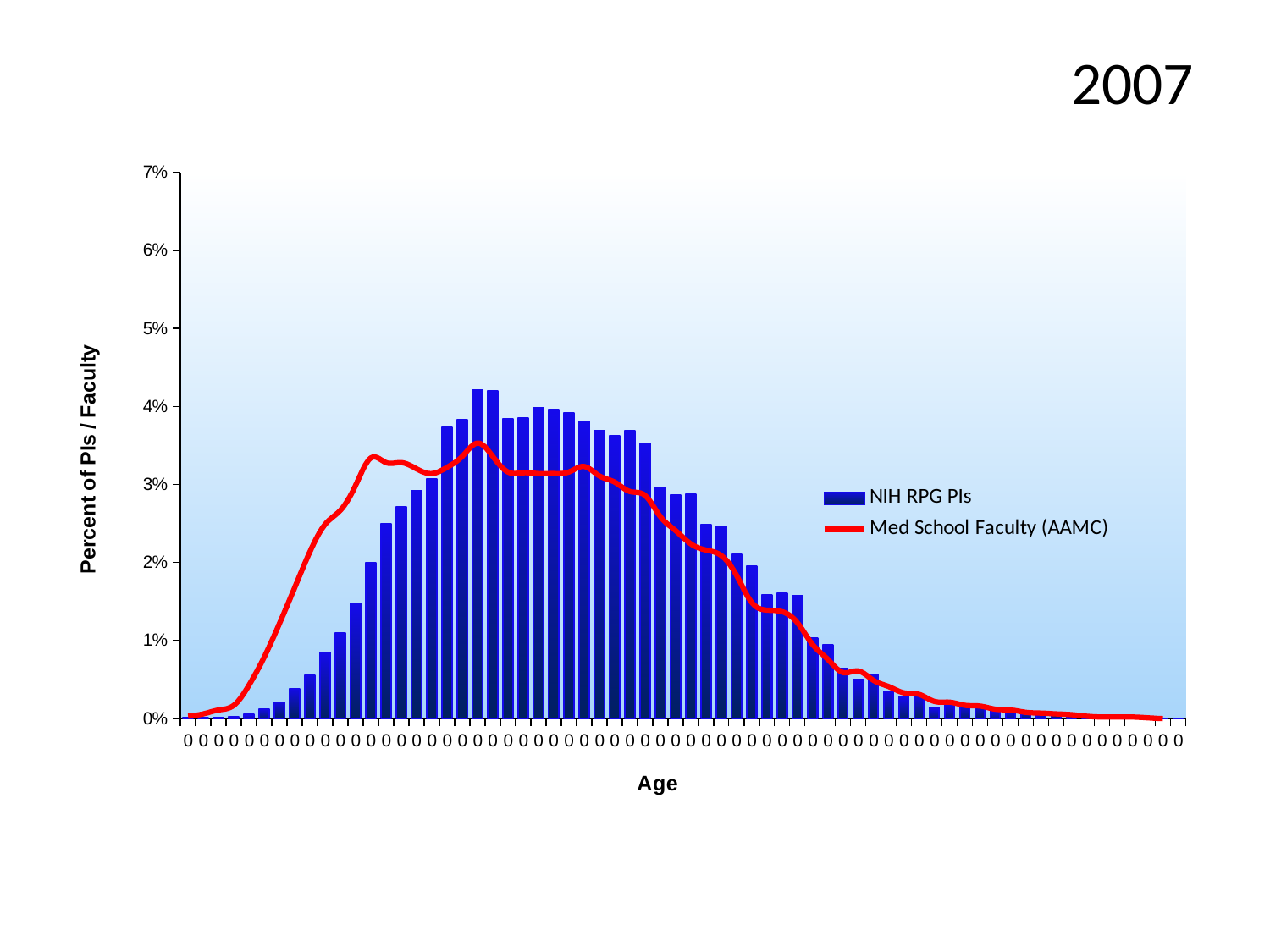
What kind of chart is shown on the slide? bar and line chart How many series does the legend list? 2 Is the highest bar value for NIH RPG PIs greater or less than 5%? less Is the peak value of the Med School Faculty (AAMC) line greater or less than 4%? less Is the highest bar value for NIH RPG PIs greater or less than 4%? greater What year is shown as the title of the slide? 2007 What are the two series named in the legend? NIH RPG PIs and Med School Faculty (AAMC) Toward the right end of the x axis, do the NIH RPG PIs bar values rise or fall? fall At the far left of the x axis, which series has the higher values, NIH RPG PIs or Med School Faculty (AAMC)? Med School Faculty (AAMC) Which series reaches the higher peak value, NIH RPG PIs or Med School Faculty (AAMC)? NIH RPG PIs